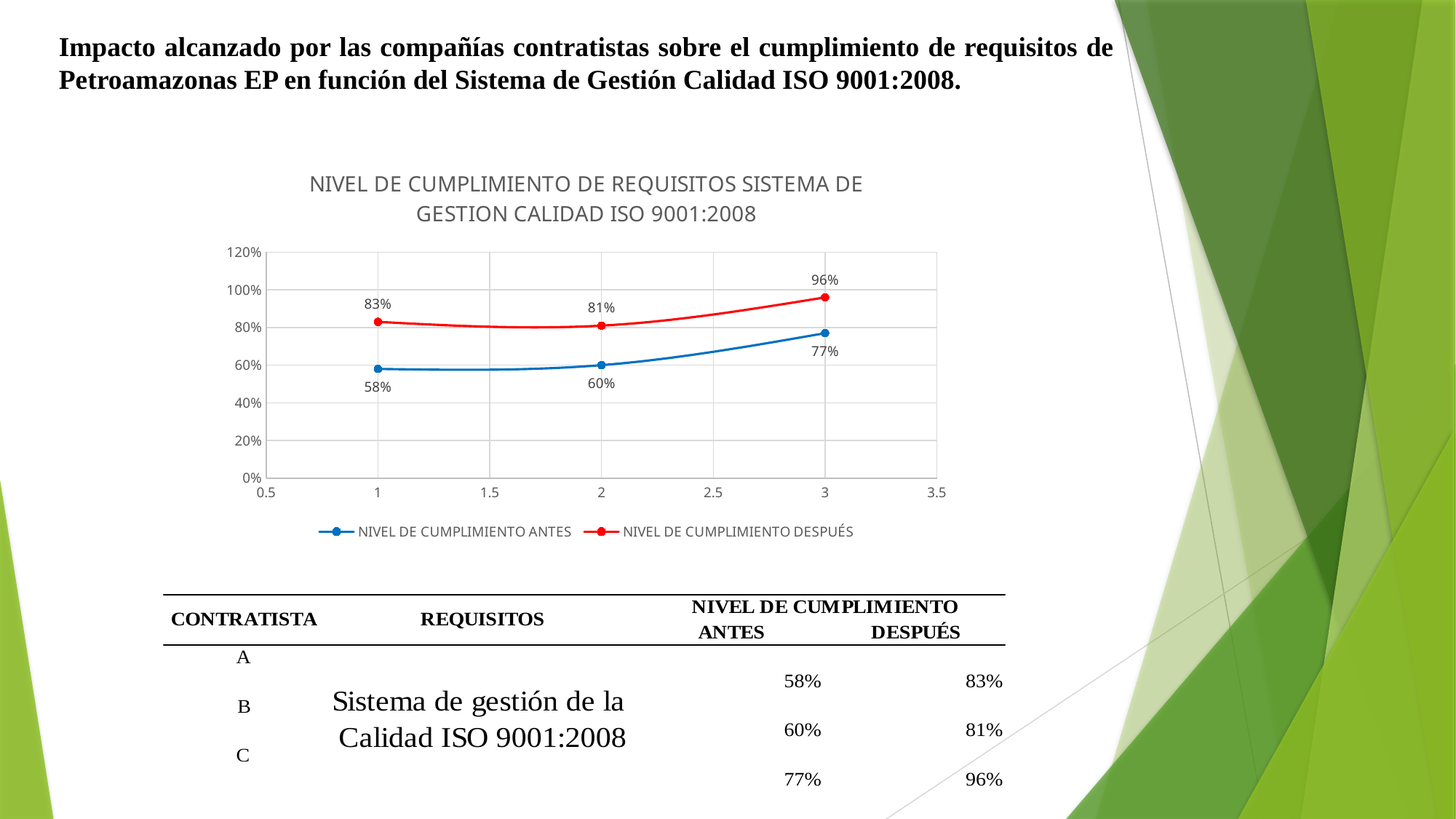
Is the value for NIVEL DE CUMPLIMIENTO ANTES at x = 3 greater or less than 60%? greater What is the value of NIVEL DE CUMPLIMIENTO DESPUÉS at x = 2? 81% What is the value of NIVEL DE CUMPLIMIENTO ANTES at x = 1? 58% What is the value of NIVEL DE CUMPLIMIENTO ANTES at x = 3? 77% At which x value is NIVEL DE CUMPLIMIENTO DESPUÉS highest? 3 What kind of chart is shown on the slide? Line chart At which x value is NIVEL DE CUMPLIMIENTO ANTES lowest? 1 How many series does the legend list? 2 Which is larger at x = 2: NIVEL DE CUMPLIMIENTO ANTES or NIVEL DE CUMPLIMIENTO DESPUÉS? NIVEL DE CUMPLIMIENTO DESPUÉS What is the value of NIVEL DE CUMPLIMIENTO DESPUÉS at x = 3? 96% Does NIVEL DE CUMPLIMIENTO ANTES rise or fall from x = 1 to x = 3? Rise What is the difference between NIVEL DE CUMPLIMIENTO DESPUÉS and NIVEL DE CUMPLIMIENTO ANTES at x = 1? 25%